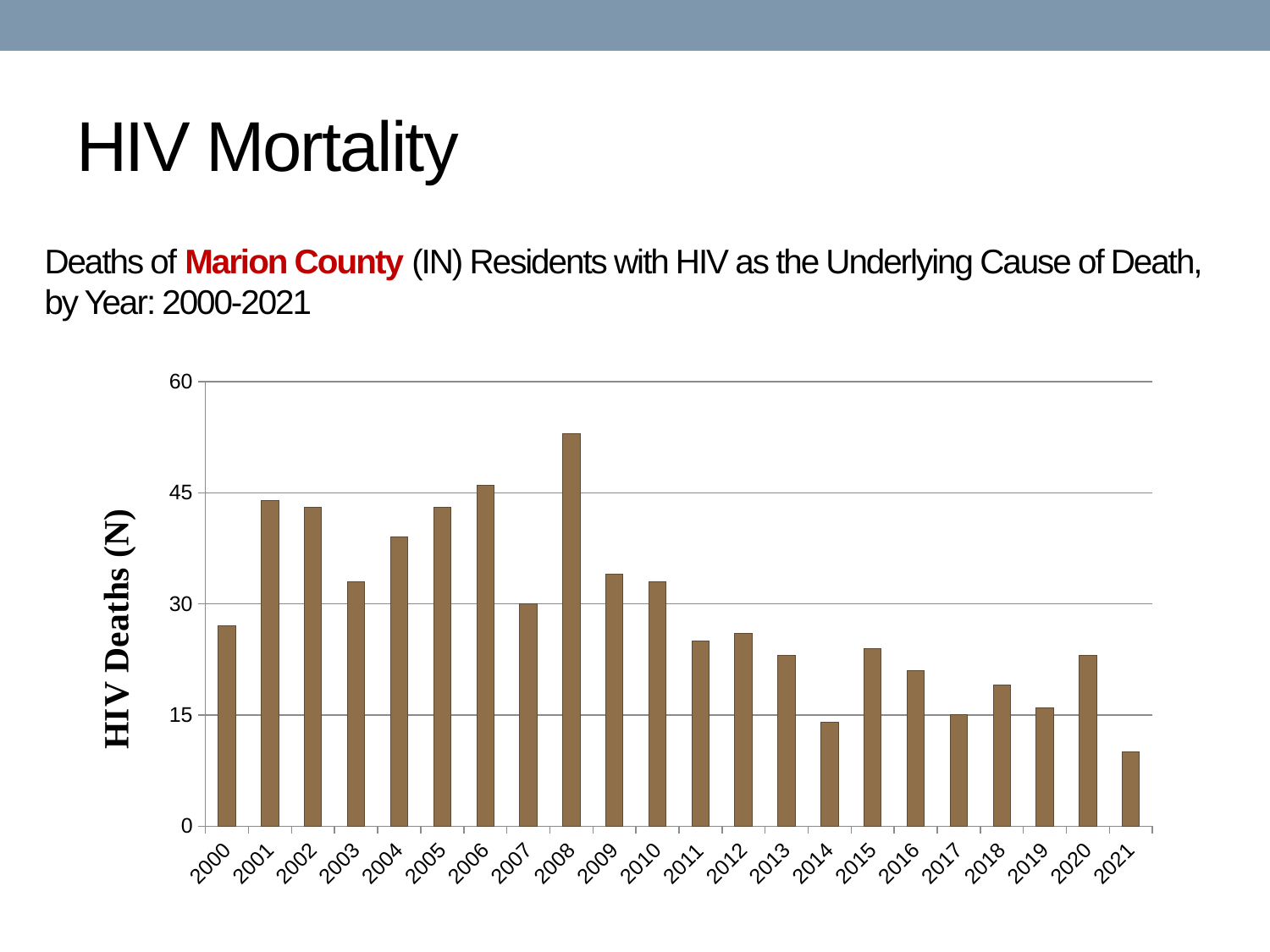
Overall, do HIV deaths rise or fall from 2000 to 2021? fall Which year has more HIV deaths, 2001 or 2011? 2001 What is the label of the y axis? HIV Deaths (N) Which year has the highest number of HIV deaths? 2008 Is the value for 2020 greater or less than 15? greater Is the value for 2000 greater or less than 30? less How many years are plotted on the x axis? 22 Which year has the lowest number of HIV deaths? 2021 Is the value for 2008 greater or less than 45? greater What kind of chart is shown on the slide? bar chart